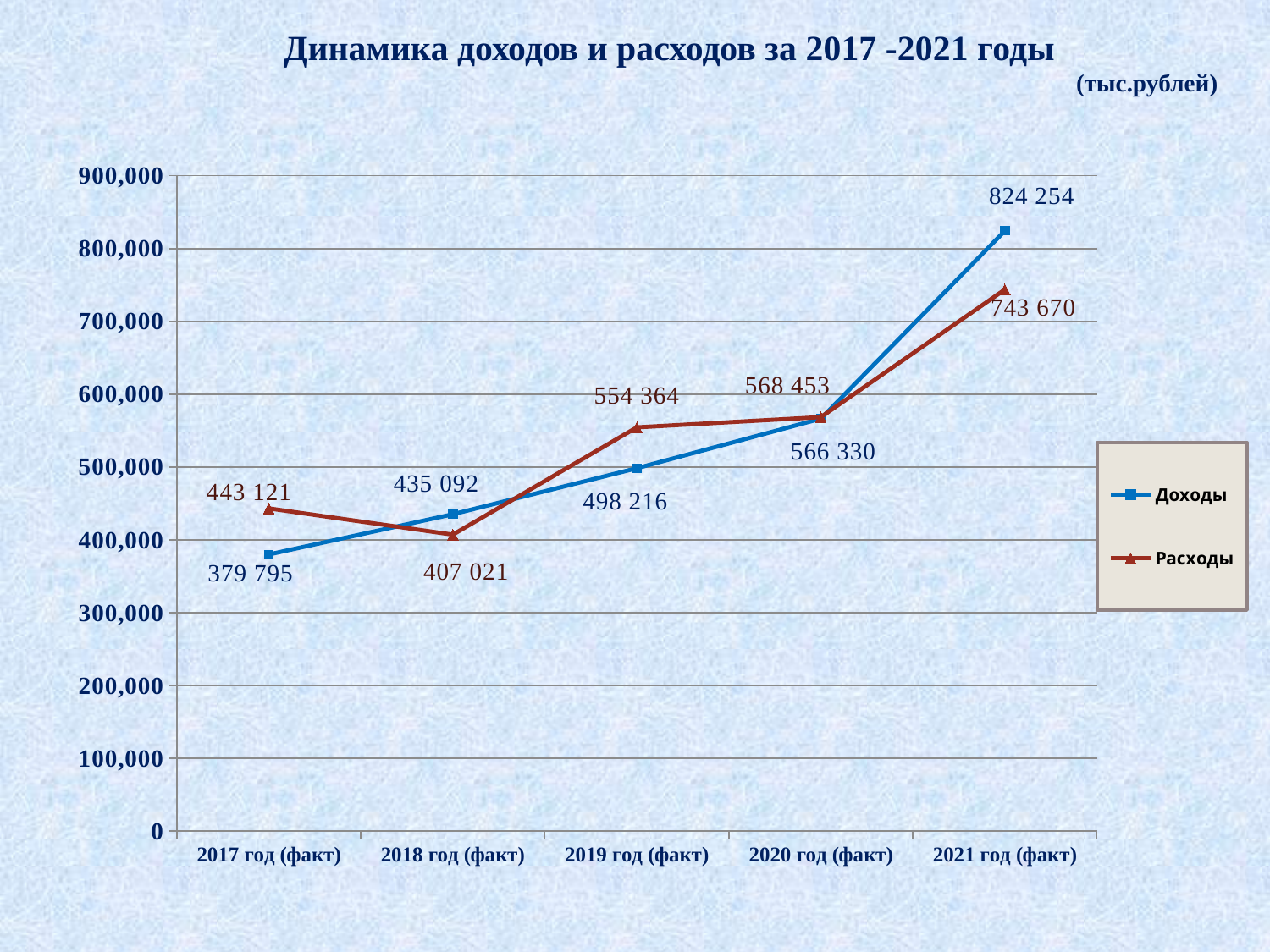
How many series does the legend list? 2 What is the value of Расходы for 2019 год (факт)? 554 364 What is the value of Доходы for 2021 год (факт)? 824 254 What is the difference between Доходы and Расходы in 2021 год (факт)? 80 584 What kind of chart is shown on the slide? Line chart How many years are shown on the x axis? 5 What is the value of Расходы for 2018 год (факт)? 407 021 In which year is Доходы highest? 2021 год (факт) Which is larger in 2017 год (факт), Доходы or Расходы? Расходы In which year is Расходы lowest? 2018 год (факт) Does Доходы rise or fall from 2017 to 2021? Rise What is the value of Доходы for 2017 год (факт)? 379 795